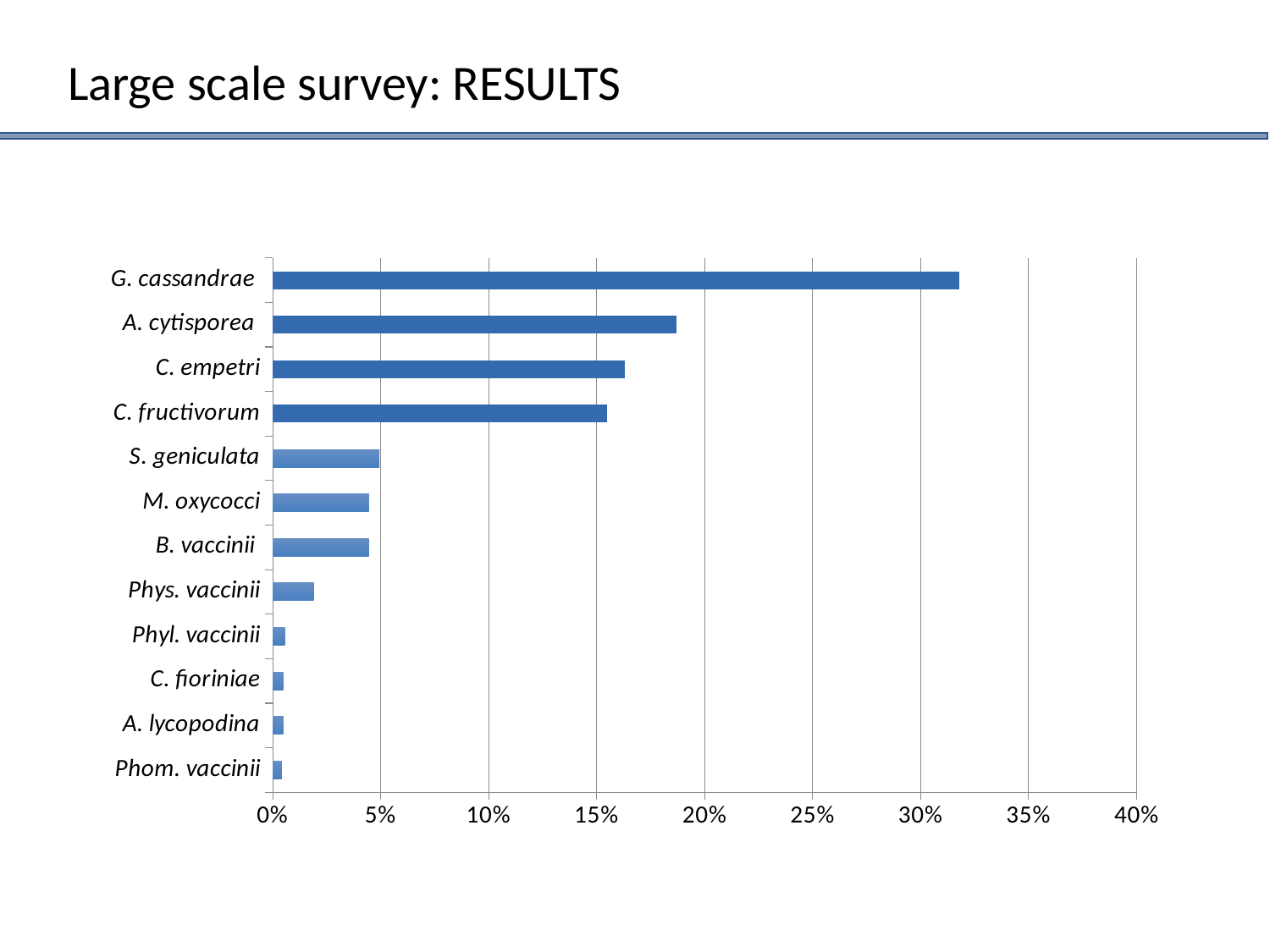
Which has a larger value, C. fructivorum or S. geniculata? C. fructivorum Is the value for S. geniculata greater or less than 10%? less What kind of chart is shown on the slide? bar chart Is the value for G. cassandrae greater or less than 30%? greater How many species are listed on the chart? 12 Is the value for Phys. vaccinii greater or less than 5%? less Which species has the highest value on the chart? G. cassandrae Which has a larger value, Phys. vaccinii or Phyl. vaccinii? Phys. vaccinii Which has a larger value, G. cassandrae or A. cytisporea? G. cassandrae What is the title of the slide containing the chart? Large scale survey: RESULTS